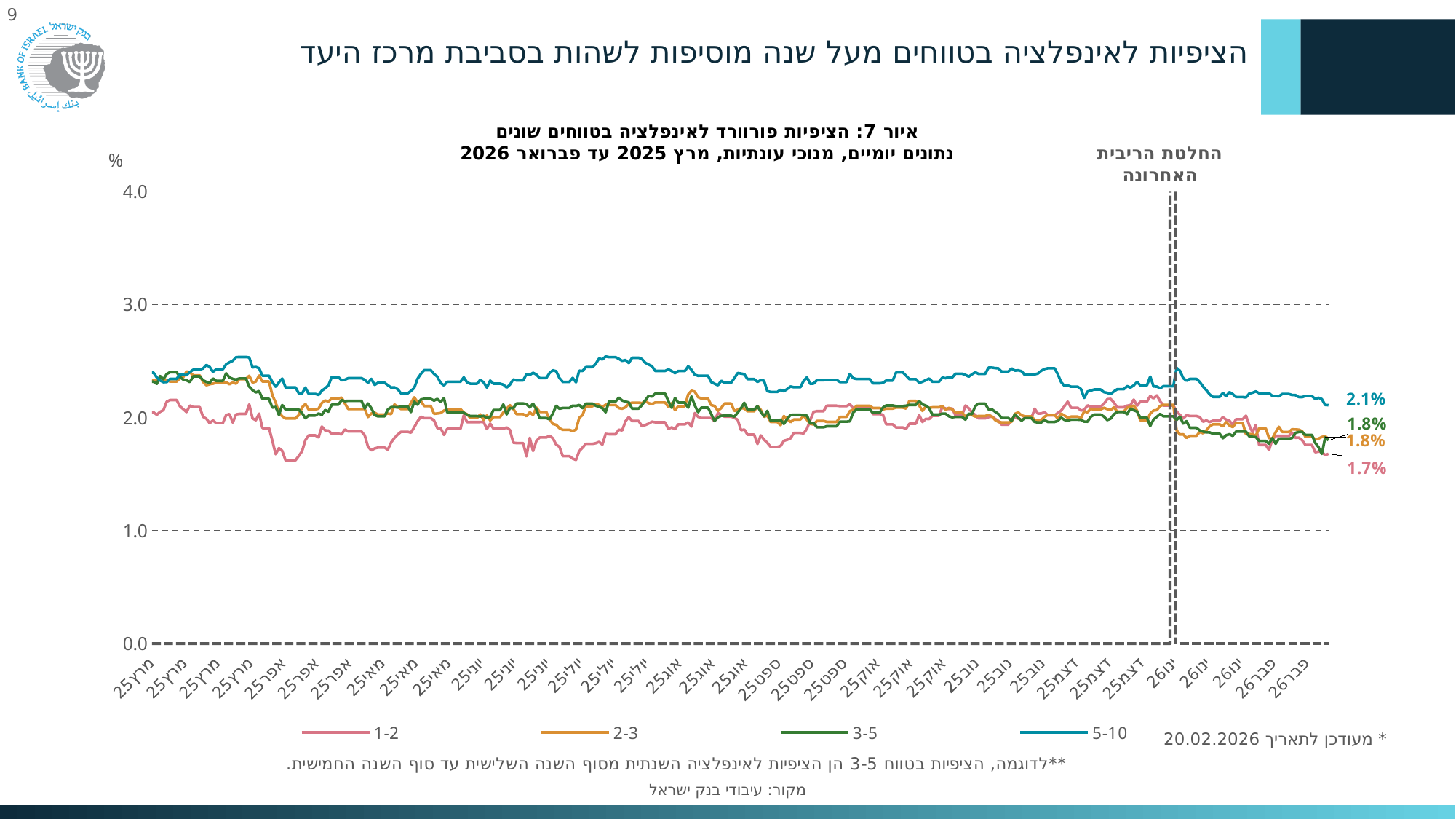
What kind of chart is shown on the slide? line chart Does the 5-10 series end higher or lower than it started in March 2025? lower What unit is shown on the y axis? % What is the latest value shown for the 1-2 series? 1.7% Which series has the highest value at the end of the period? 5-10 What is the latest value shown for the 2-3 series? 1.8% What is the difference between the end-of-period values of the 5-10 series and the 1-2 series? 0.4% How many series does the legend list? 4 Is the end-of-period value of the 5-10 series greater or less than 2.0? greater What is the latest value shown for the 5-10 series? 2.1% What is the latest value shown for the 3-5 series? 1.8% Which series has the lowest value at the end of the period? 1-2